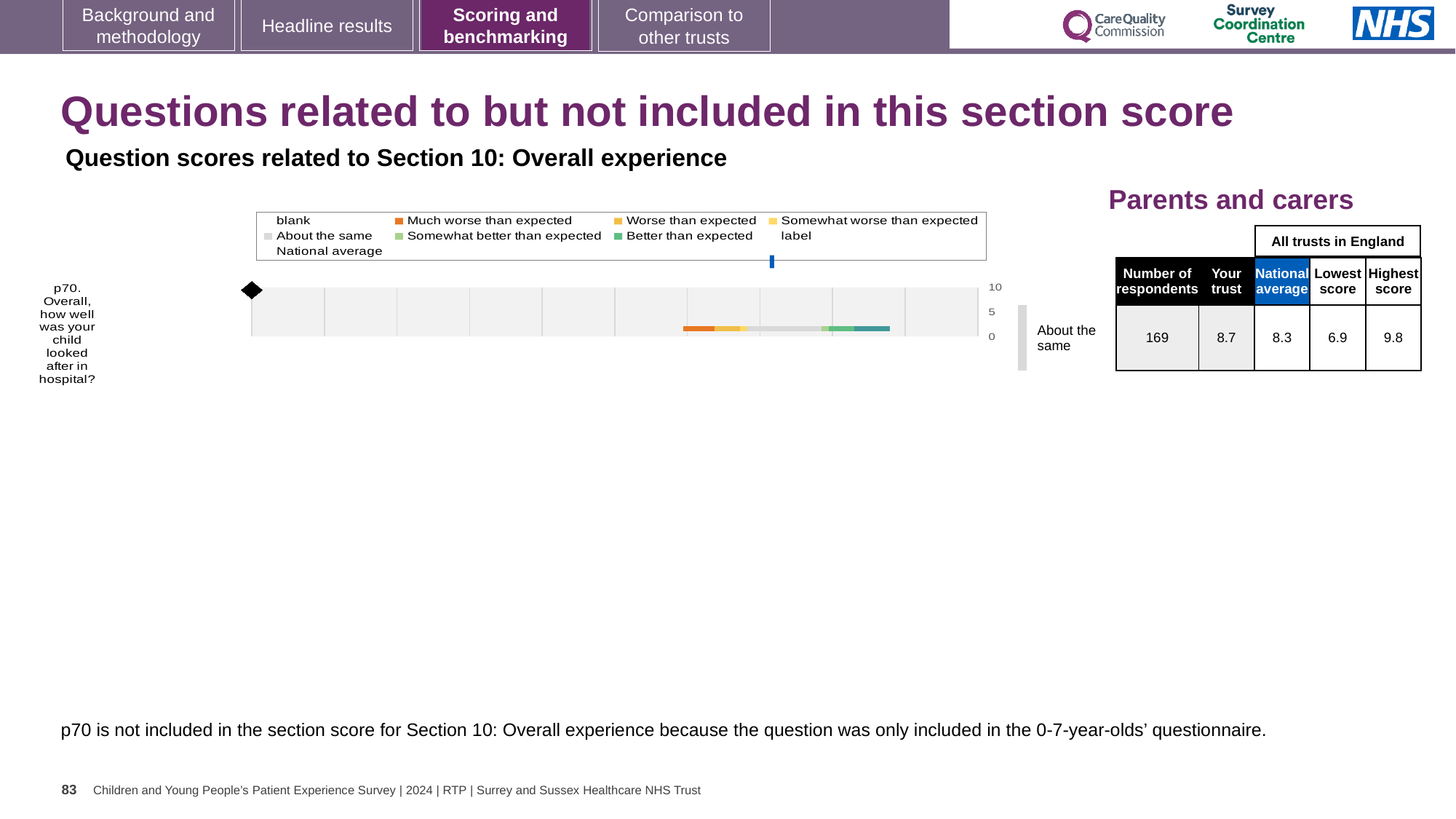
What category label is shown to the right of the p70 bar? About the same What is the highest score among all trusts in England for p70? 9.8 Which is higher for p70: the 'Your trust' score or the national average? Your trust What kind of chart is used to show the p70 results? bar chart Which question is plotted in the chart? p70. Overall, how well was your child looked after in hospital? Is the 'Your trust' score for p70 greater or less than 5? greater What is the difference between the highest score and the lowest score for p70? 2.9 What is the 'Your trust' score for p70? 8.7 What is the lowest score among all trusts in England for p70? 6.9 How many questions are plotted in the chart? 1 How many respondents answered p70? 169 What is the national average score for p70? 8.3